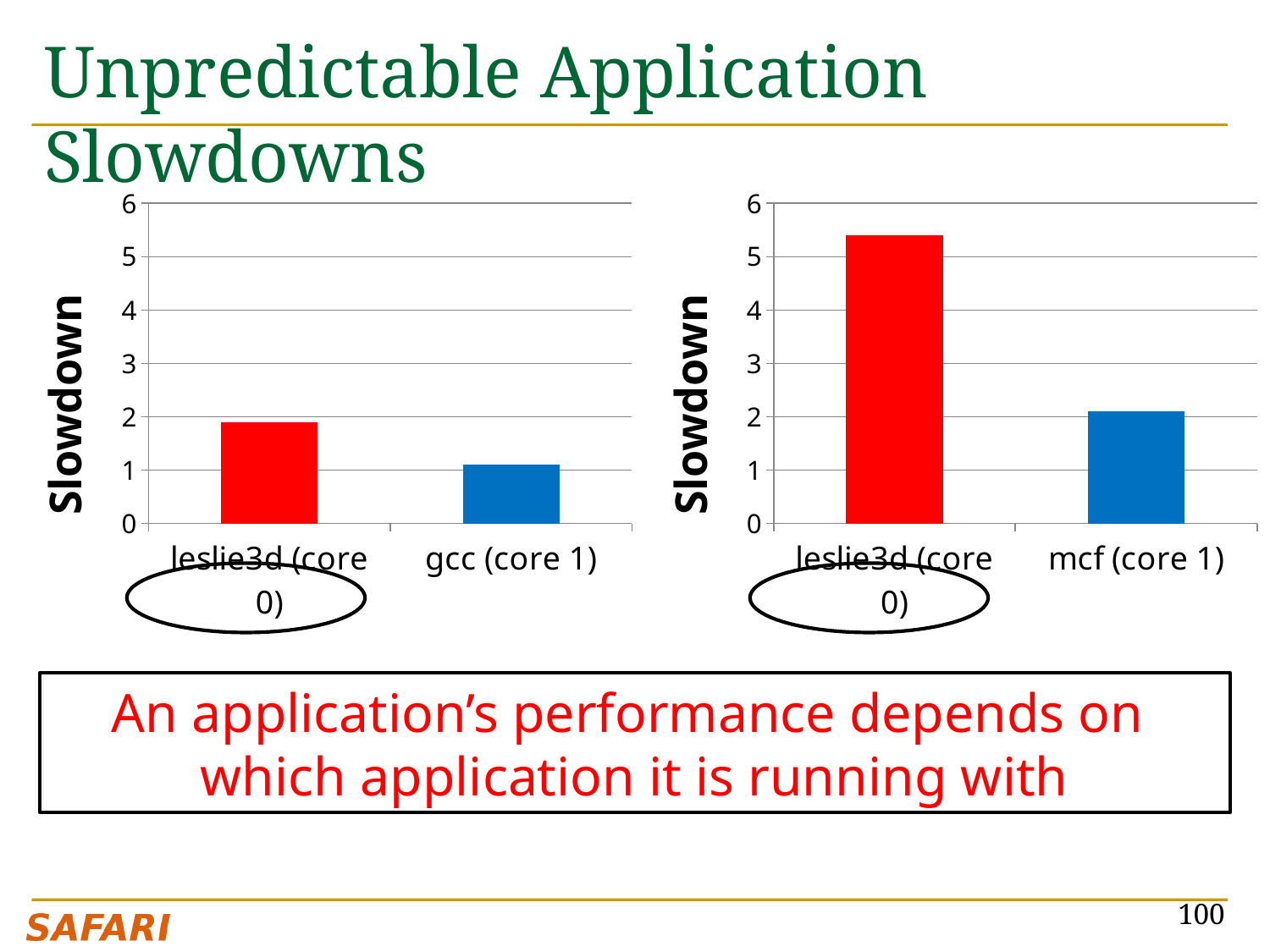
In the right chart, is the slowdown for mcf (core 1) greater or less than 3? less In the left chart, is the slowdown for leslie3d (core 0) greater or less than 1? greater In the right chart, which is larger, the slowdown for leslie3d (core 0) or for mcf (core 1)? leslie3d (core 0) What is the y-axis label of the left chart? Slowdown In the right chart, which category has the highest slowdown? leslie3d (core 0) In the left chart, which category has the highest slowdown? leslie3d (core 0) In the right chart, which category has the lowest slowdown? mcf (core 1) In the left chart, is the slowdown for gcc (core 1) greater or less than 2? less How many categories are shown in the right chart? 2 What type of chart is the left chart on the slide? bar chart In the left chart, which category has the lowest slowdown? gcc (core 1)